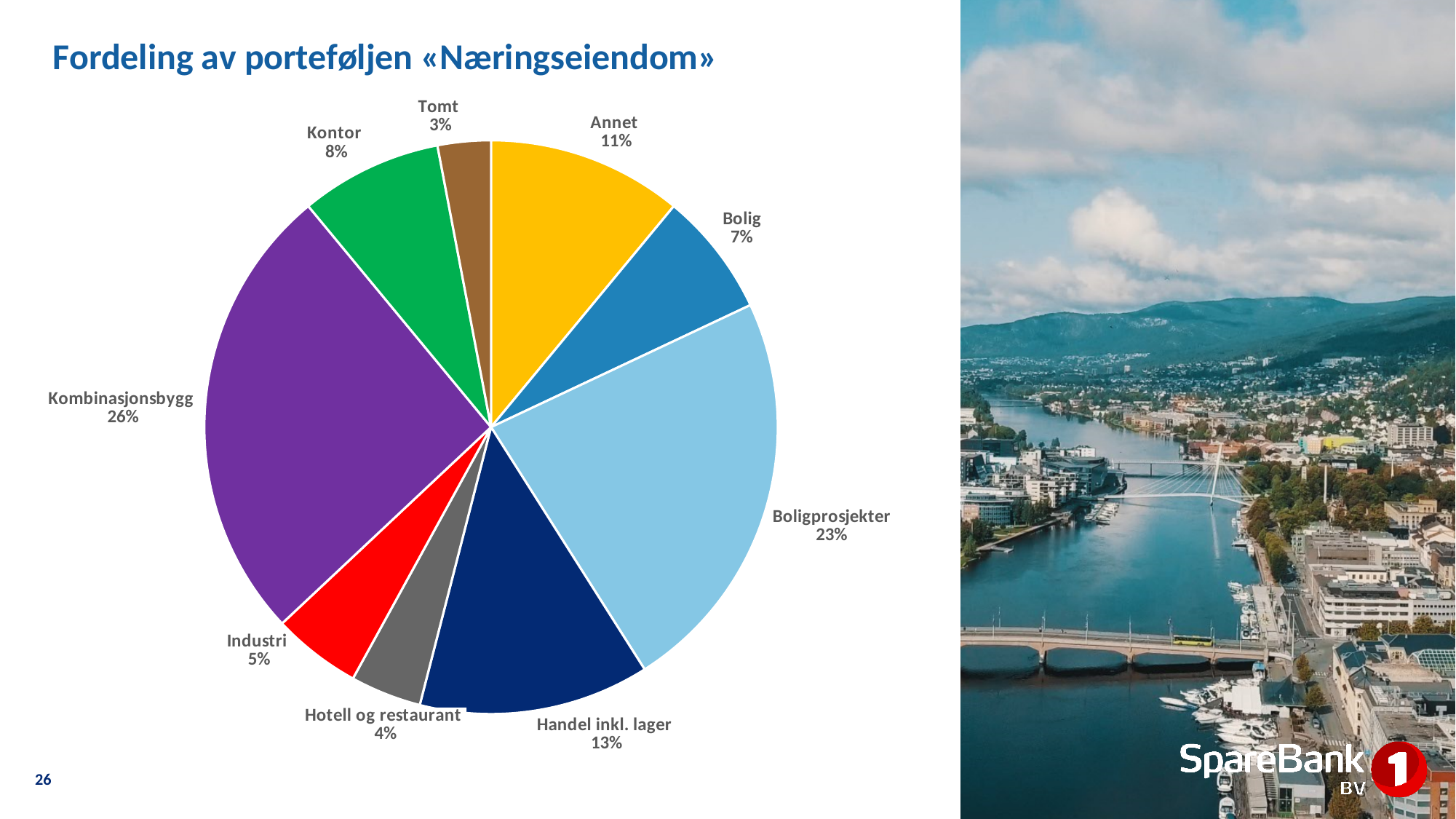
Which is larger, Kontor or Bolig? Kontor What kind of chart is shown on the slide? Pie chart What share of the portfolio is Kombinasjonsbygg? 26% What share of the portfolio is Boligprosjekter? 23% How many categories are shown in the pie chart? 9 What colour is the Industri slice? Red What is the value shown for Tomt? 3% Which category has the smallest share of the portfolio? Tomt Which category has the largest share of the portfolio? Kombinasjonsbygg What is the title of the chart? Fordeling av porteføljen «Næringseiendom» What is the difference in percentage points between Kombinasjonsbygg and Boligprosjekter? 3 percentage points What is the value shown for Handel inkl. lager? 13%